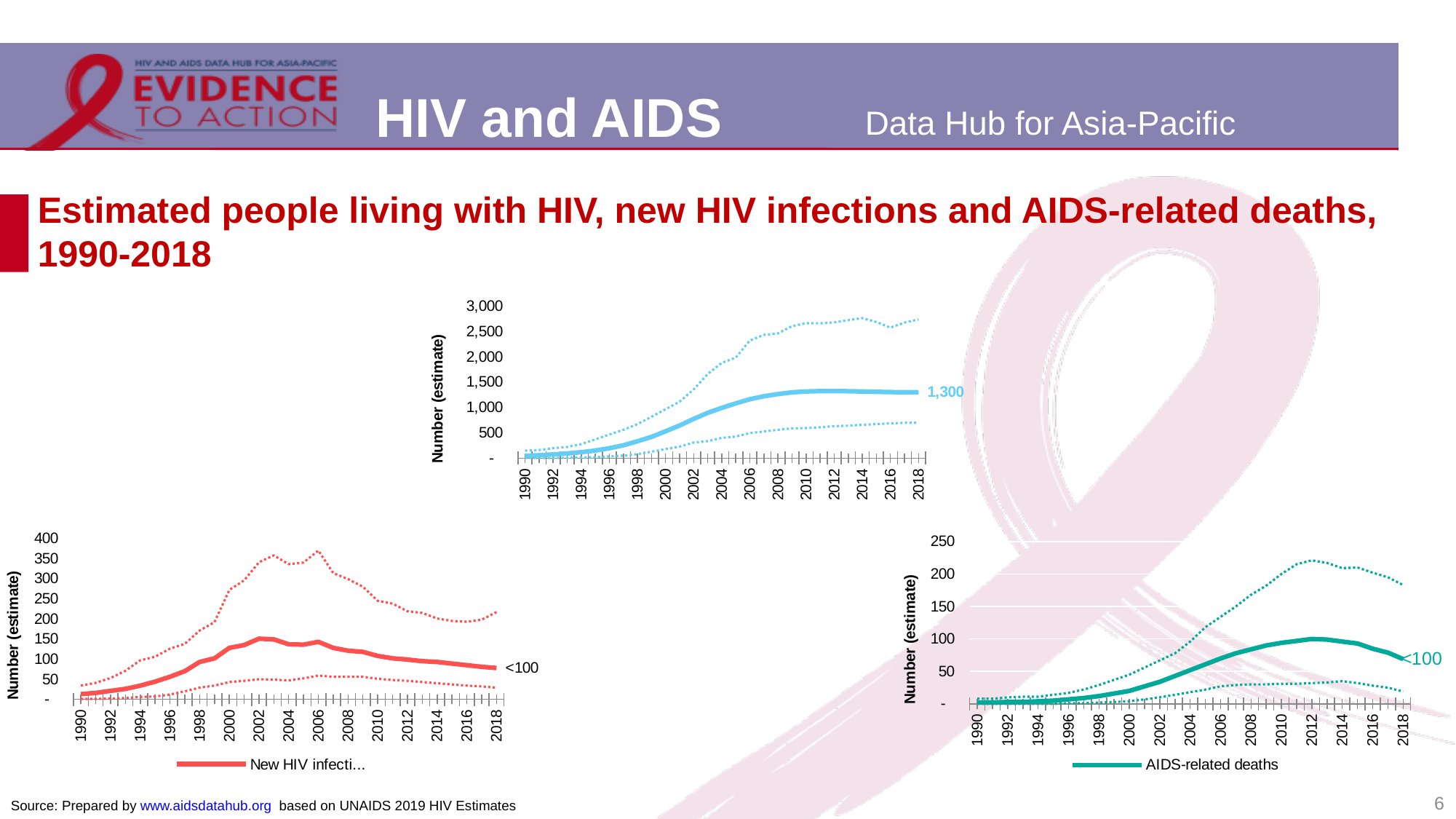
In the bottom-left chart, does the solid line rise or fall between 2006 and 2018? fall In the bottom-left chart, is the value of the solid line in 2003 greater or less than 100? greater What kind of chart is the top chart on the slide? line chart What is the y-axis title of the bottom-right chart? Number (estimate) In the bottom-right chart, does the solid line rise or fall between 2000 and 2012? rise In the top chart, does the solid line rise or fall between 1990 and 2010? rise In the bottom-right chart, is the value of the solid line in 2012 greater or less than 50? greater In the bottom-left chart, what value is labelled at the end of the solid line in 2018? <100 In the top chart, is the value of the solid line in 2000 greater or less than 1,000? less In the top chart, what value is labelled at the end of the solid line in 2018? 1,300 What series does the legend of the bottom-right chart list? AIDS-related deaths In the bottom-right chart, what value is labelled at the end of the solid line in 2018? <100